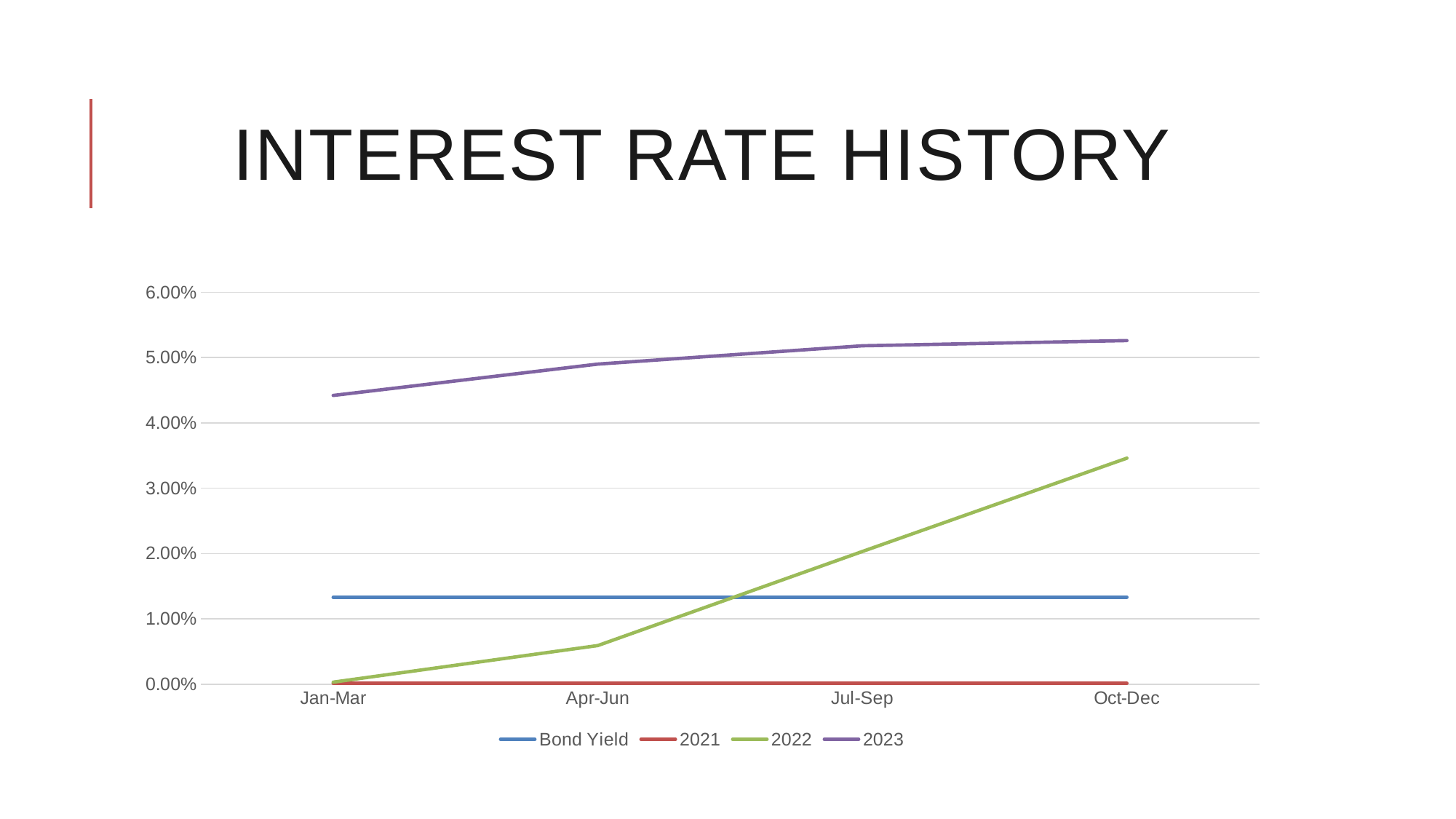
How many categories are shown on the x axis? 4 Which series is highest across all quarters? 2023 Is the value for 2022 in Oct-Dec greater or less than 3.00%? greater Which series is lowest across all quarters? 2021 Is the value for 2023 in Jan-Mar greater or less than 4.00%? greater What is the title of the chart? INTEREST RATE HISTORY Does the 2022 series rise or fall from Jan-Mar to Oct-Dec? rise What kind of chart is shown on the slide? line chart How many series does the legend list? 4 Is the value for 2022 in Apr-Jun greater or less than 1.00%? less Does the 2023 series rise or fall from Jan-Mar to Oct-Dec? rise Which is larger in Jul-Sep, the 2022 value or the Bond Yield value? 2022